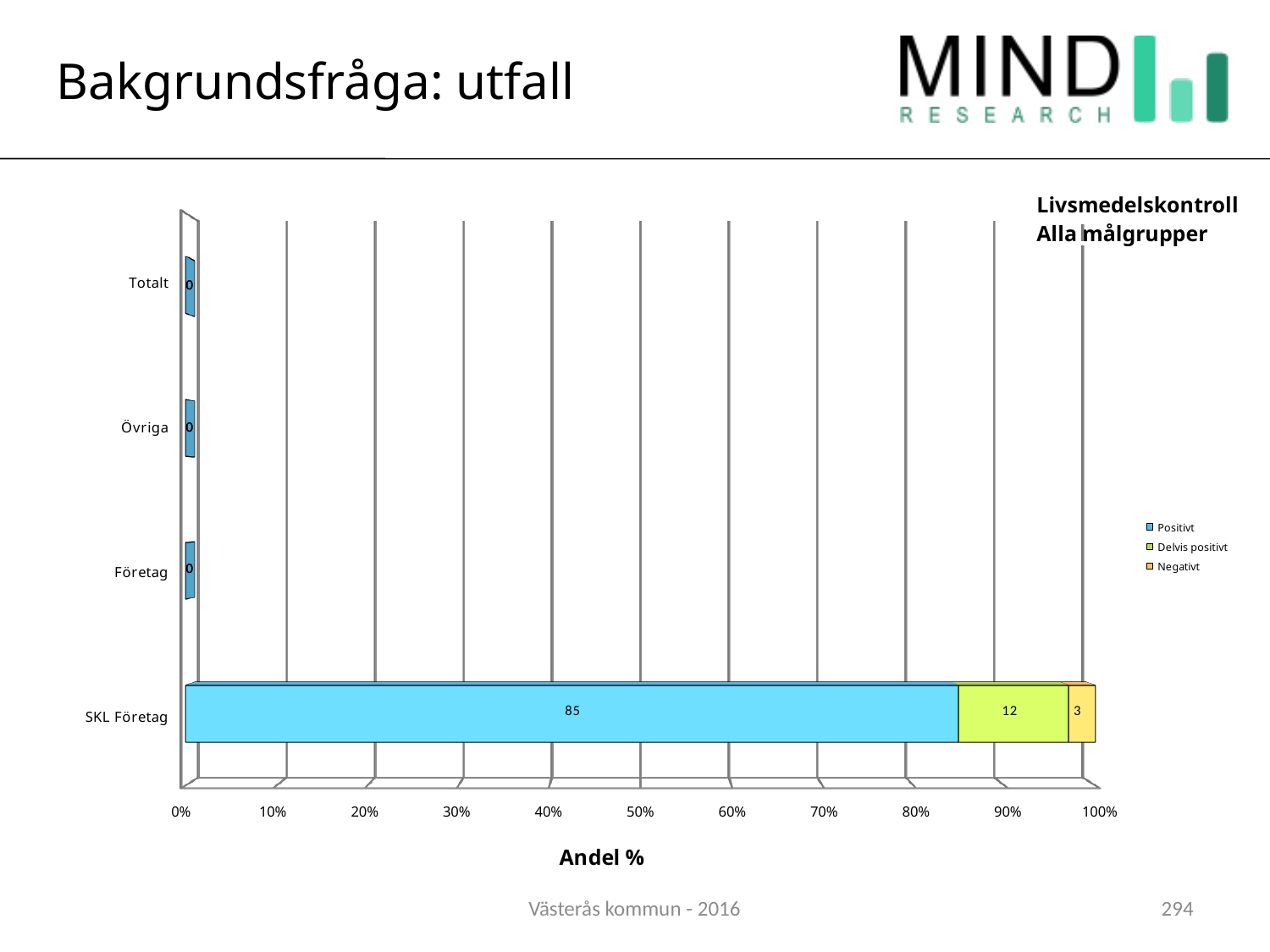
What is the difference between the Positivt and Delvis positivt values for SKL Företag? 73 How many categories are shown on the vertical axis? 4 What is the Negativt value for SKL Företag? 3 What is the Positivt value for Totalt? 0 What is the label of the horizontal axis? Andel % How many series does the legend list? 3 Which category has the highest Positivt value? SKL Företag What is the Positivt value for SKL Företag? 85 What is the Delvis positivt value for SKL Företag? 12 What kind of chart is shown on the slide? bar chart Is the Positivt value for SKL Företag greater or less than 80%? greater What is the total of the stacked bar for SKL Företag? 100